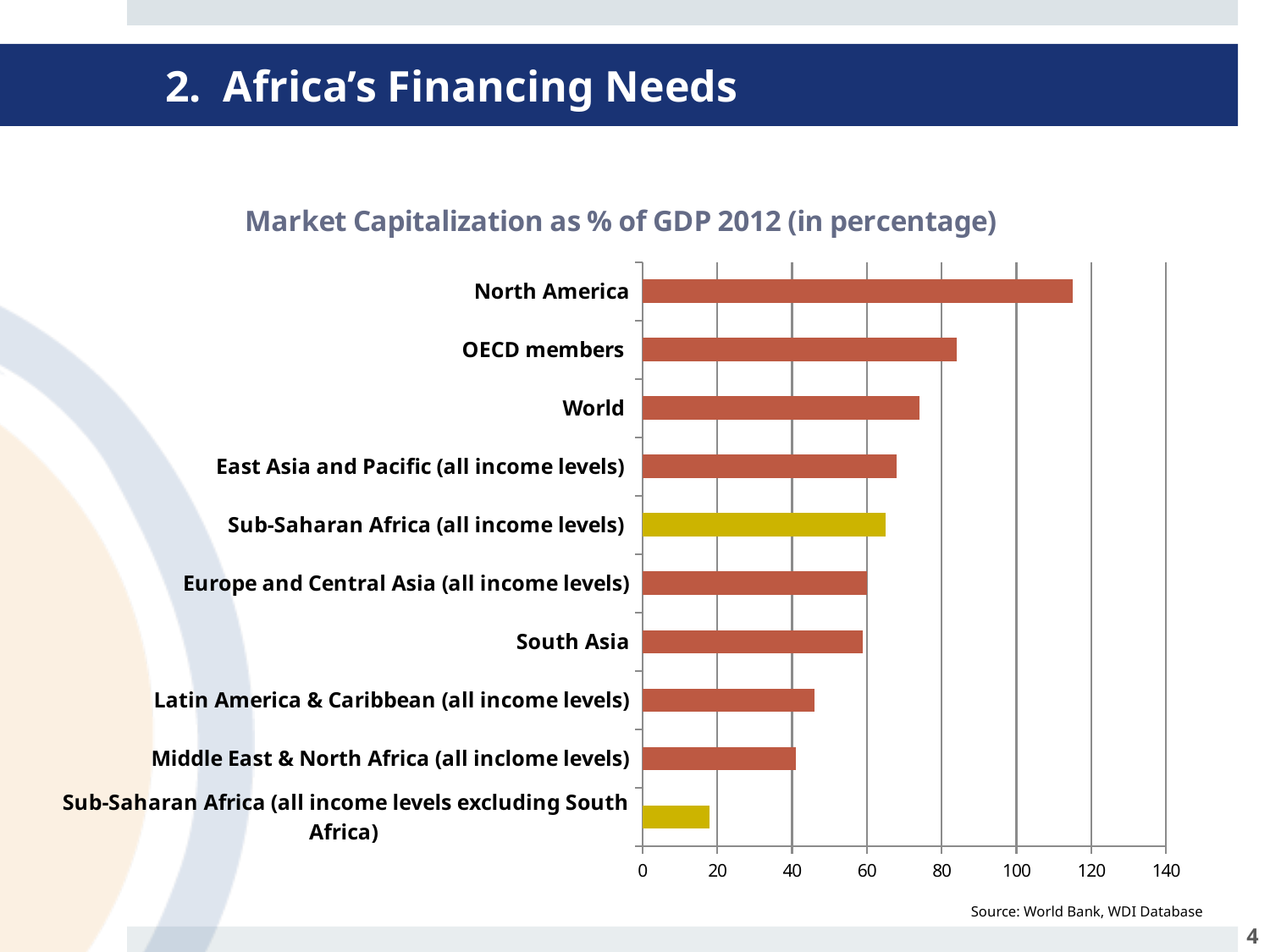
Is the value for North America greater or less than 100? greater What kind of chart is shown on the slide? bar chart Is the value for World greater or less than 80? less How many regions or groups are plotted in the chart? 10 Which is larger, the value for OECD members or the value for World? OECD members Is the value for OECD members greater or less than 80? greater What is the title of the chart? Market Capitalization as % of GDP 2012 (in percentage) Which bar is coloured differently (yellow) from the others? Sub-Saharan Africa (all income levels) Which region has the lowest market capitalization as % of GDP? Sub-Saharan Africa (all income levels excluding South Africa) Which region has the highest market capitalization as % of GDP? North America